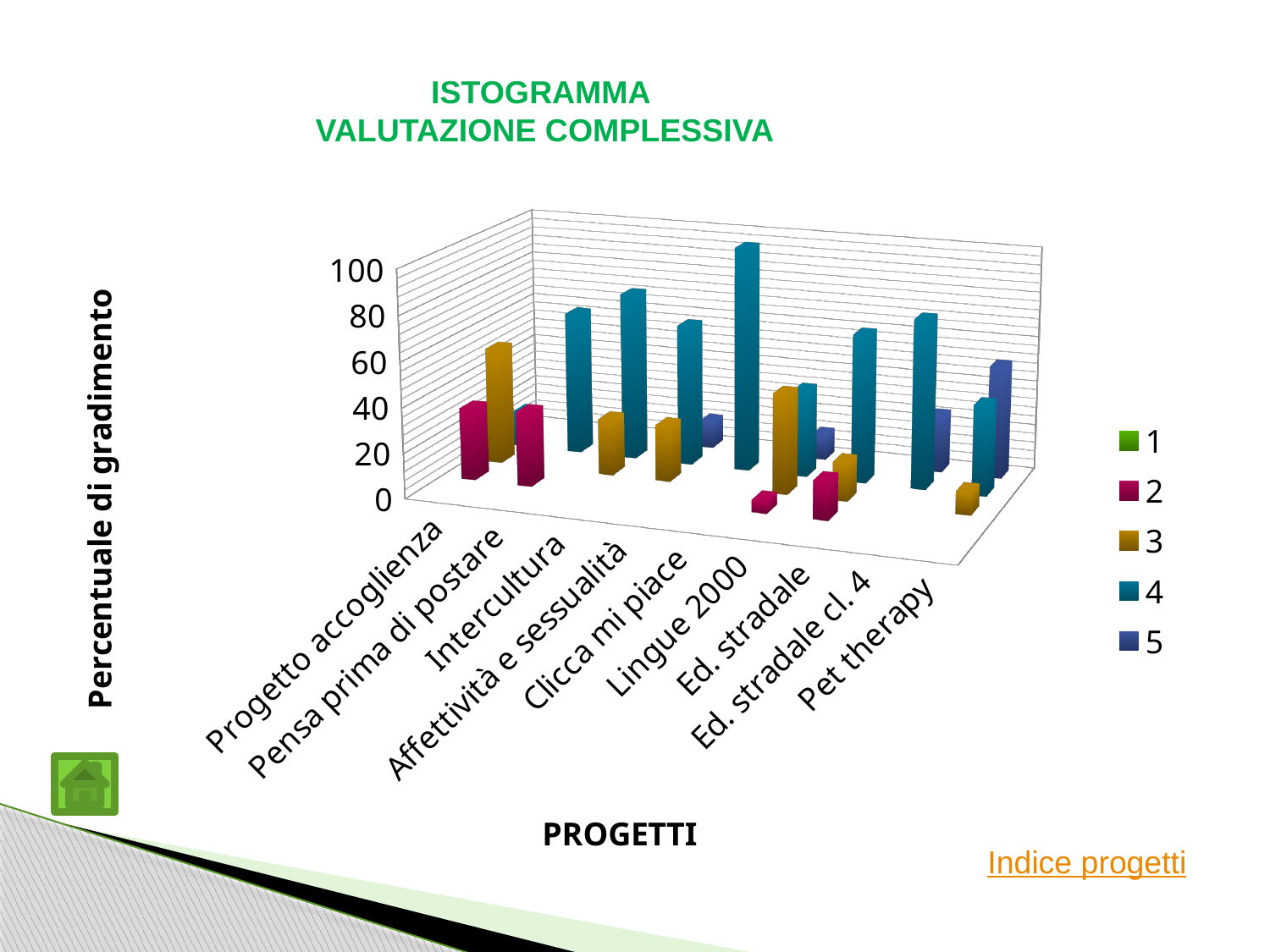
How many series does the chart's legend list? 5 Is the value of series 4 for Lingue 2000 greater or less than 60? less What is the title of the horizontal axis of the chart? PROGETTI Which project has the tallest bar in the chart? Clicca mi piace Is the value of series 3 for Progetto accoglienza greater or less than 20? greater What is the title of the vertical axis of the chart? Percentuale di gradimento Is the value of series 2 for Ed. stradale greater or less than 20? less How many project categories are shown on the x axis of the chart? 9 What kind of chart is shown on the slide? bar chart